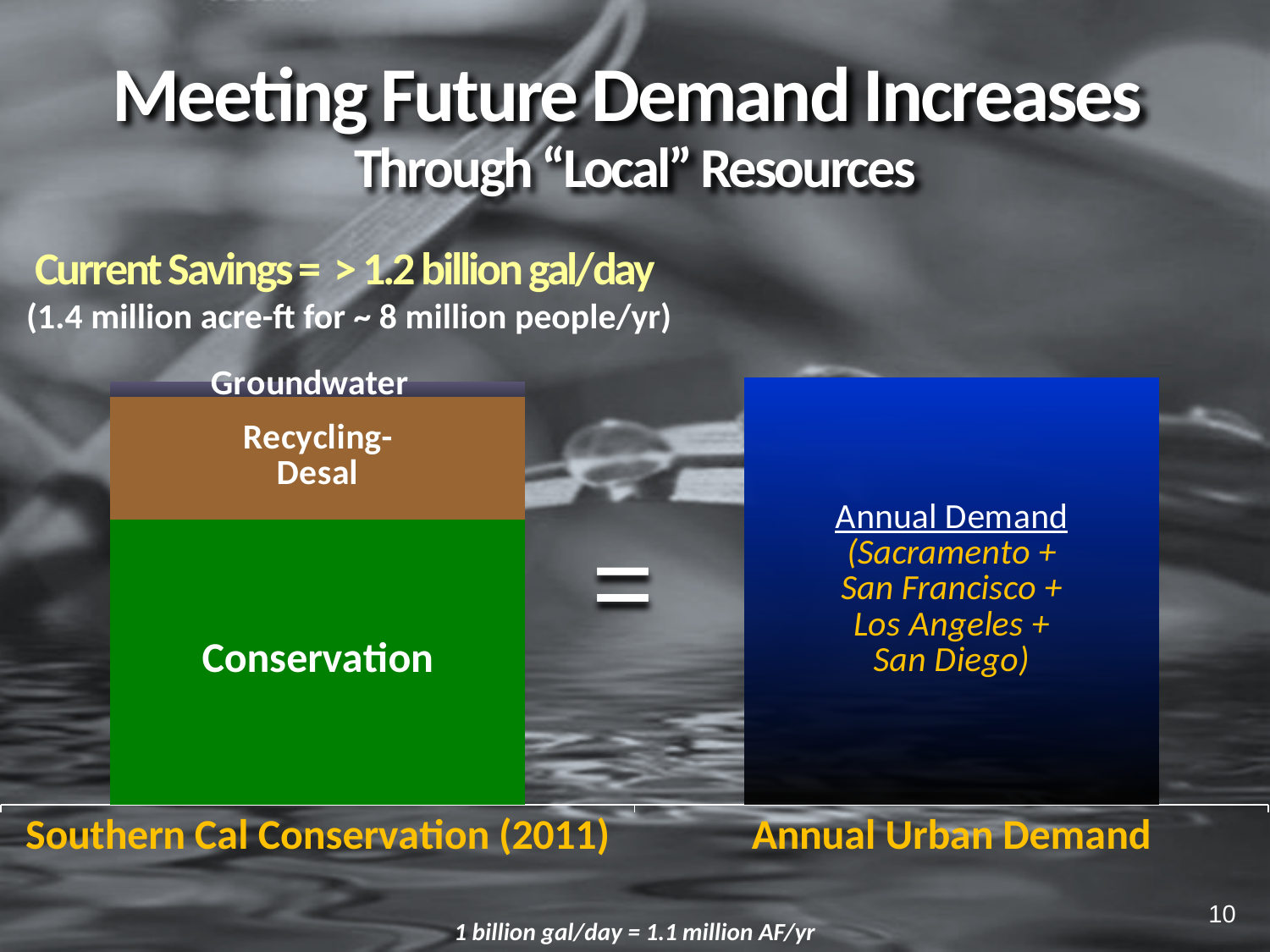
How many bars (categories) are shown along the bottom of the chart? 2 Which segment of the Southern Cal Conservation (2011) bar is the largest? Conservation How many segments make up the Southern Cal Conservation (2011) bar? 3 Which segment of the Southern Cal Conservation (2011) bar is the smallest? Groundwater Which is larger in the Southern Cal Conservation (2011) bar, the Recycling-Desal segment or the Groundwater segment? Recycling-Desal Which segment sits at the top of the Southern Cal Conservation (2011) stacked bar? Groundwater What colour is the Conservation segment of the bar? green Which is larger in the Southern Cal Conservation (2011) bar, the Conservation segment or the Recycling-Desal segment? Conservation What are the two category labels under the bars? Southern Cal Conservation (2011) and Annual Urban Demand Is the Southern Cal Conservation (2011) bar taller, shorter, or about the same height as the Annual Urban Demand bar? about the same What kind of chart is shown on the slide? stacked bar chart Which four cities are listed inside the Annual Urban Demand bar? Sacramento, San Francisco, Los Angeles, San Diego